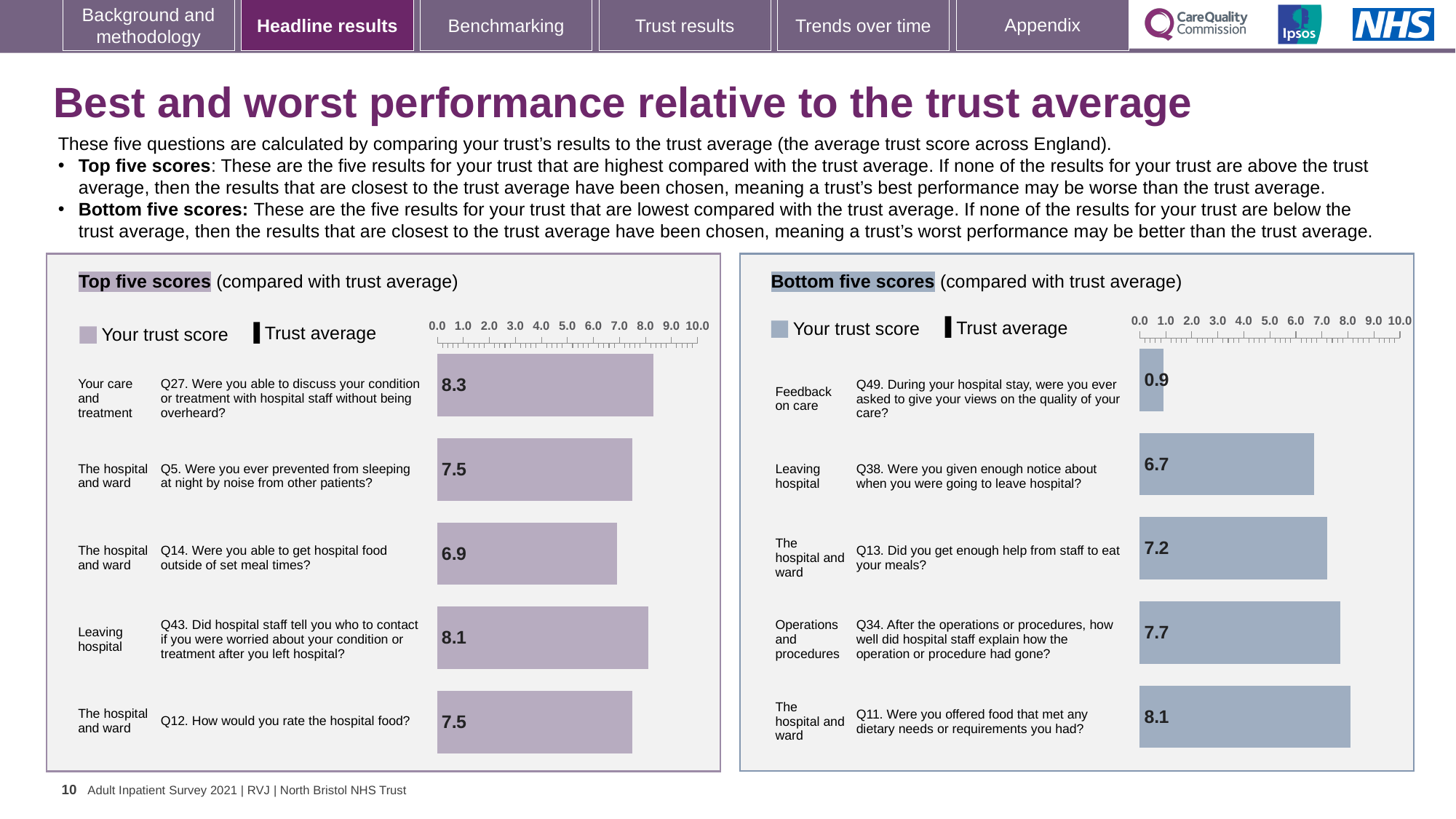
How many questions are plotted in the 'Top five scores' chart? 5 In the 'Top five scores' chart, which question has the highest trust score? Q27 In the 'Bottom five scores' chart, which question has the lowest trust score? Q49 In the 'Top five scores' chart, what is the trust score for Q27 (discussing your condition without being overheard)? 8.3 In the 'Bottom five scores' chart, what is the difference between the trust scores for Q11 and Q38? 1.4 In the 'Bottom five scores' chart, is the trust score for Q13 greater or less than 5.0? greater In the 'Top five scores' chart, what is the trust score for Q14 (getting hospital food outside of set meal times)? 6.9 In the 'Top five scores' chart, which has the larger trust score: Q43 or Q5? Q43 In the 'Bottom five scores' chart, what is the trust score for Q49 (asked to give your views on the quality of your care)? 0.9 What kind of chart is used in the 'Bottom five scores' panel? Bar chart In the 'Bottom five scores' chart, what is the trust score for Q34 (how well staff explained how the operation or procedure had gone)? 7.7 How many entries does the legend of the 'Top five scores' chart list? 2